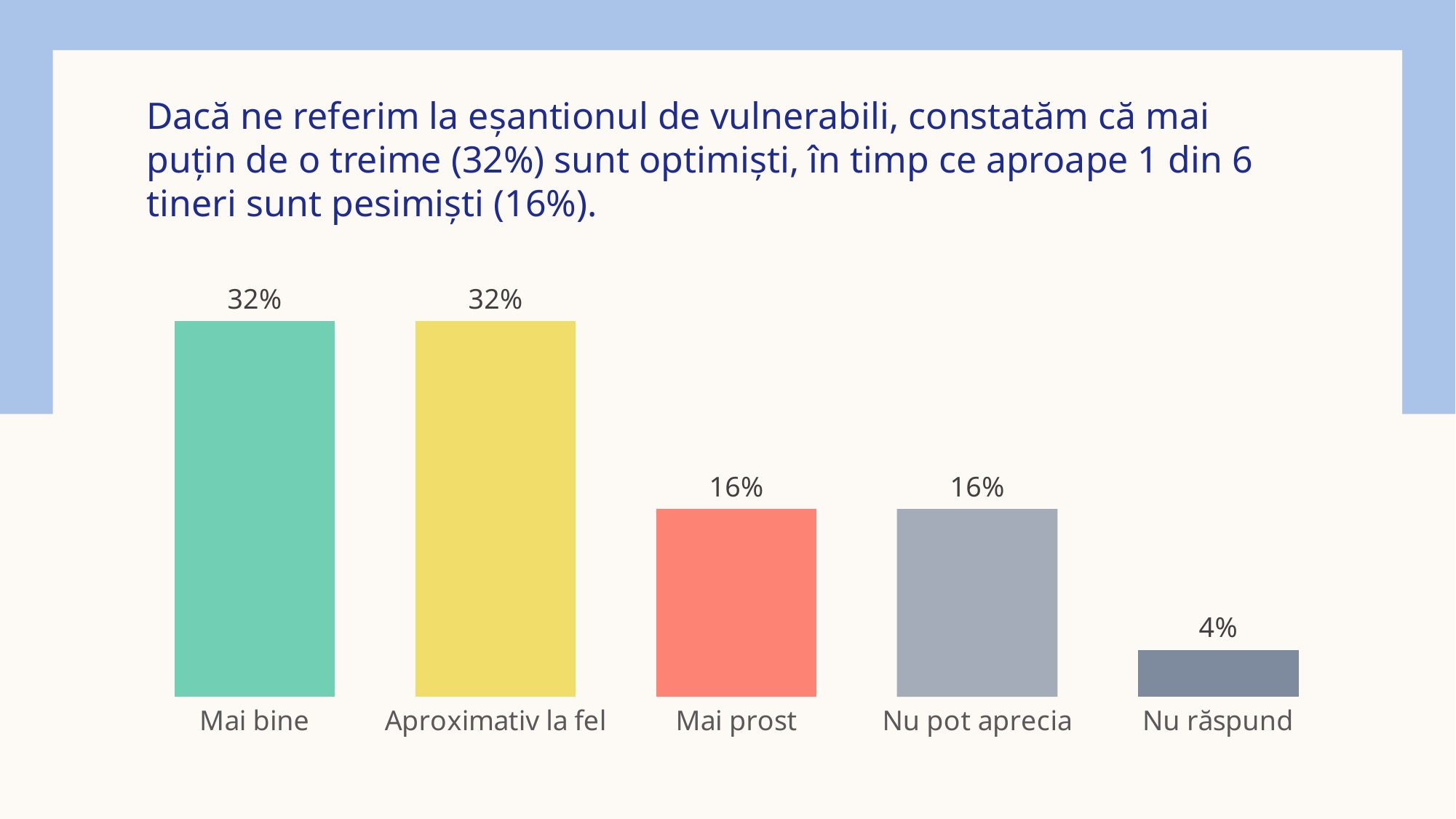
What kind of chart is shown on the slide? Bar chart What colour is the bar for Mai prost? Red What is the value for Mai bine? 32% What is the value for Nu pot aprecia? 16% What is the value for Nu răspund? 4% What is the difference between the values for Mai bine and Mai prost? 16% Which is larger, the value for Aproximativ la fel or the value for Nu pot aprecia? Aproximativ la fel What is the value for Mai prost? 16% What is the difference between the values for Nu pot aprecia and Nu răspund? 12% How many categories are shown in the chart? 5 Which category has the lowest value? Nu răspund Do the values rise or fall from left to right across the categories? Fall